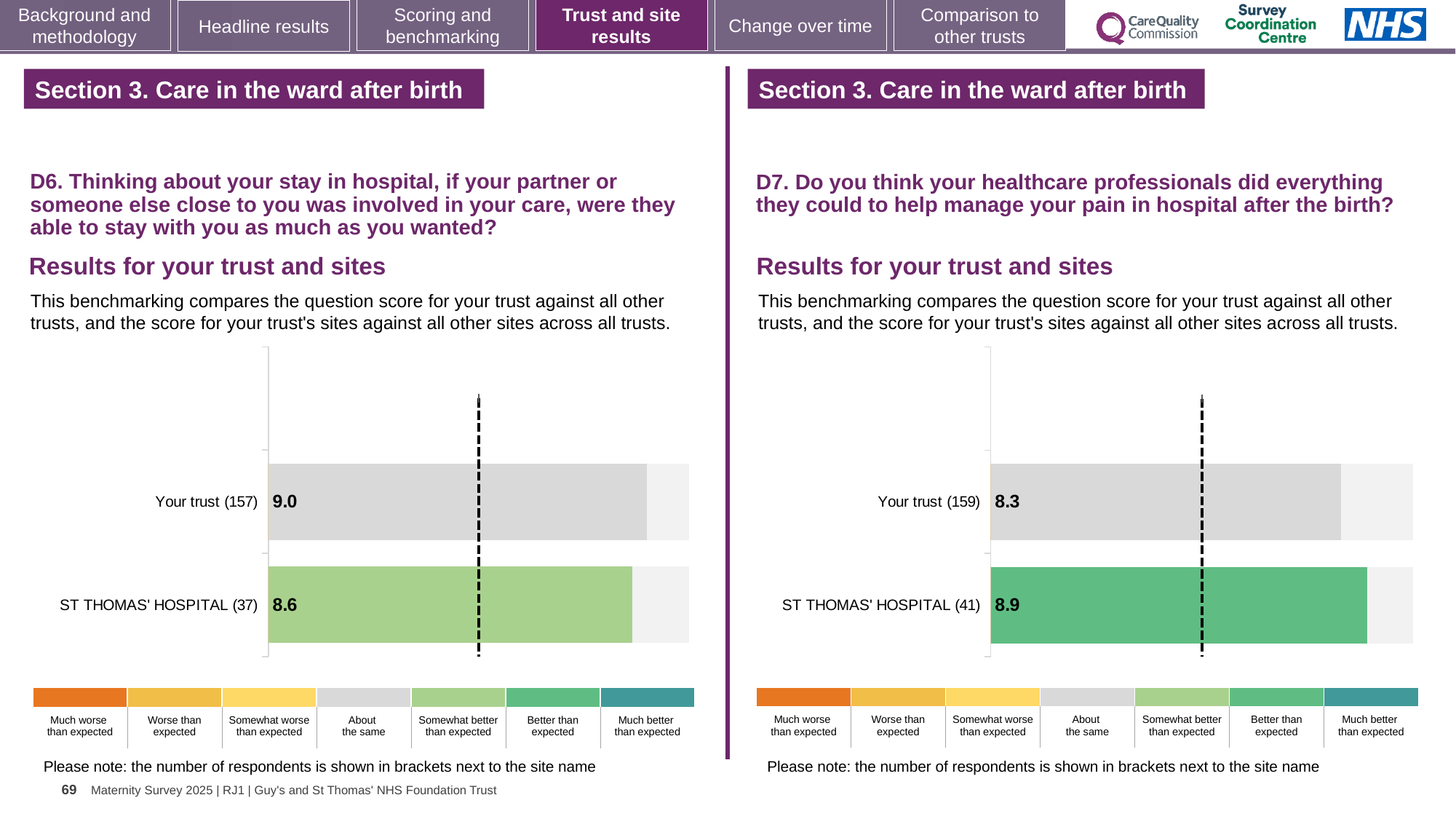
In the D6 chart on the left, how many respondents are shown in brackets for ST THOMAS' HOSPITAL? 37 In the D6 chart on the left, what is the score for ST THOMAS' HOSPITAL? 8.6 In the D6 chart on the left, what is the score for Your trust? 9.0 In the D7 chart on the right, what is the difference between the score for ST THOMAS' HOSPITAL and the score for Your trust? 0.6 In the D7 chart on the right, what is the score for Your trust? 8.3 In the D6 chart on the left, which has the higher score, Your trust or ST THOMAS' HOSPITAL? Your trust What kind of chart is used in the D7 chart on the right? Bar chart In the D7 chart on the right, what is the score for ST THOMAS' HOSPITAL? 8.9 How many bars are plotted in the D6 chart on the left? 2 In the D7 chart on the right, which has the lower score, Your trust or ST THOMAS' HOSPITAL? Your trust In the D7 chart on the right, how many respondents are shown in brackets for Your trust? 159 In the D6 chart on the left, what is the difference between the score for Your trust and the score for ST THOMAS' HOSPITAL? 0.4